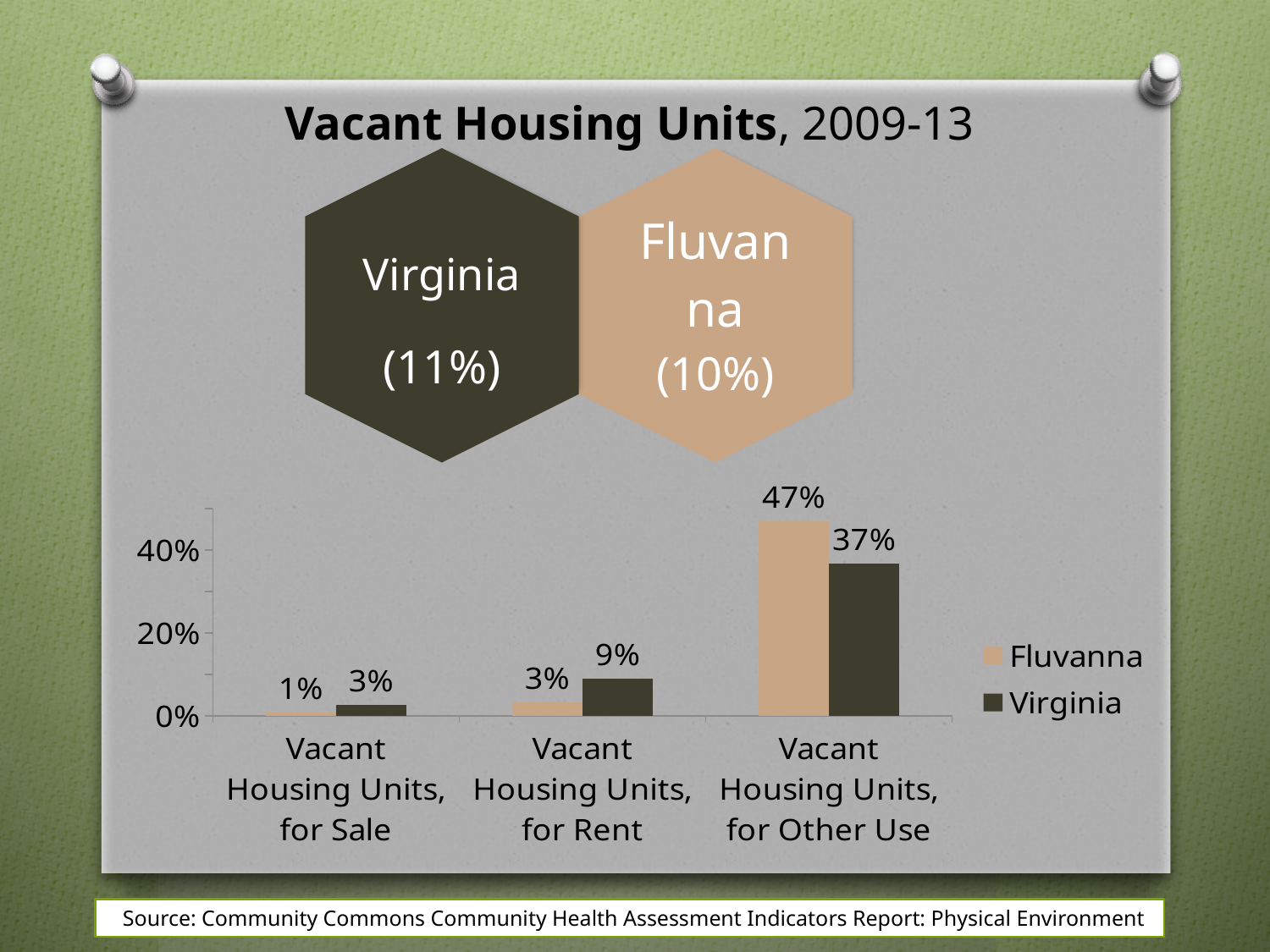
What is the value for Virginia for Vacant Housing Units, for Rent? 9% What is the value for Virginia for Vacant Housing Units, for Other Use? 37% Which category has the lowest value for Fluvanna? Vacant Housing Units, for Sale What is the value for Fluvanna for Vacant Housing Units, for Sale? 1% Is the value for Fluvanna for Vacant Housing Units, for Other Use greater or less than 40%? greater Which is larger for Vacant Housing Units, for Rent: Fluvanna or Virginia? Virginia What is the difference between Fluvanna and Virginia for Vacant Housing Units, for Other Use? 10% How many categories are shown on the x axis of the chart? 3 What is the value for Fluvanna for Vacant Housing Units, for Other Use? 47% How many series does the legend list? 2 Which category has the highest value for Virginia? Vacant Housing Units, for Other Use What kind of chart is shown on the slide? bar chart